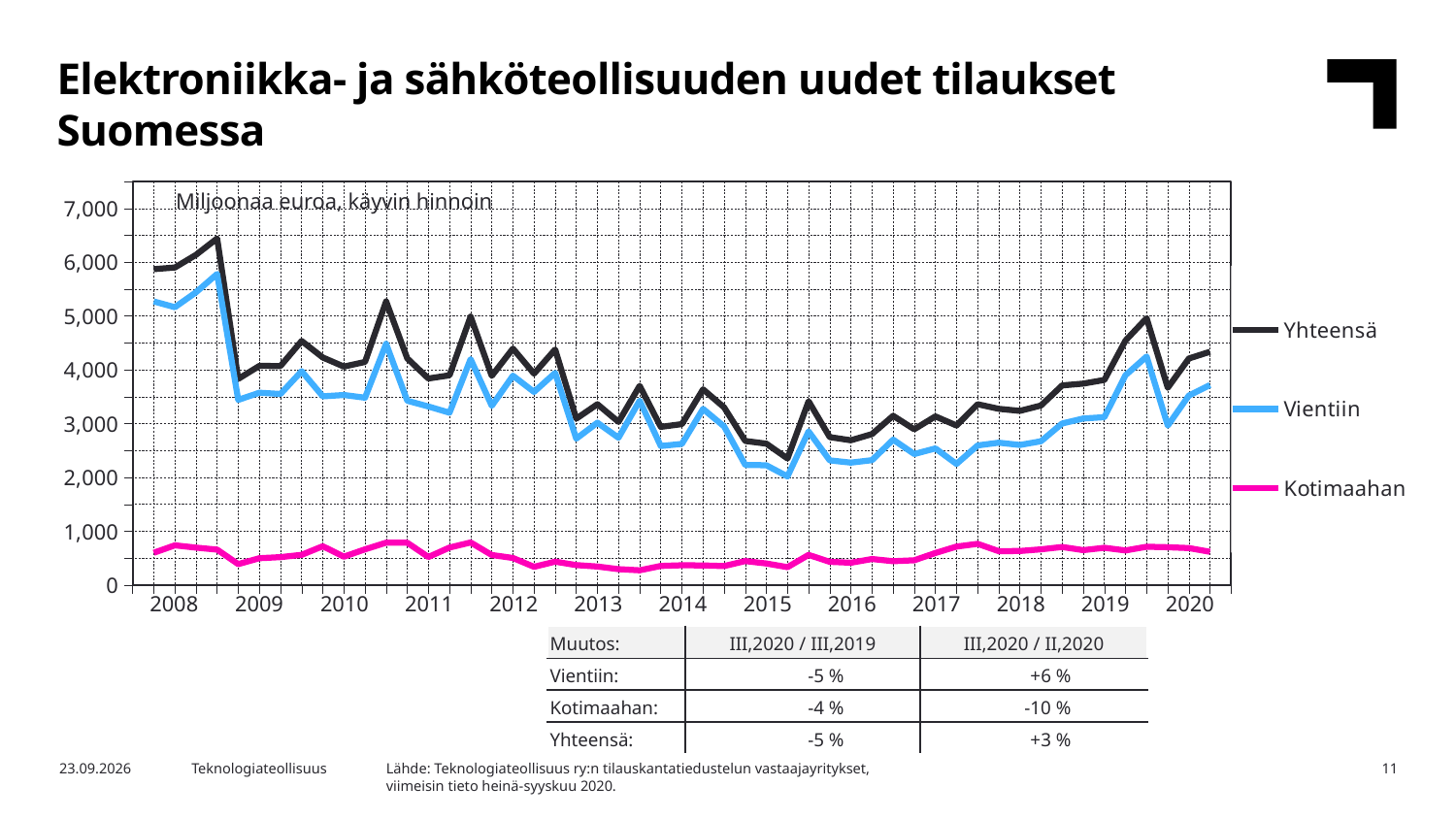
Which is larger in 2018, Vientiin or Kotimaahan? Vientiin Does the Yhteensä series overall rise or fall from 2008 to 2015? fall Is the peak value of Yhteensä in 2008 greater or less than 6,000? greater Which series has the highest values throughout the chart? Yhteensä How many series does the legend list? 3 What unit is stated at the top of the chart area? Miljoonaa euroa, käyvin hinnoin Is the value for Kotimaahan in 2011 greater or less than 1,000? less Which series has the lowest values throughout the chart? Kotimaahan Is the peak value of Yhteensä in 2019 greater or less than 4,000? greater How many years are labelled on the x axis? 13 What kind of chart is shown on the slide? line chart